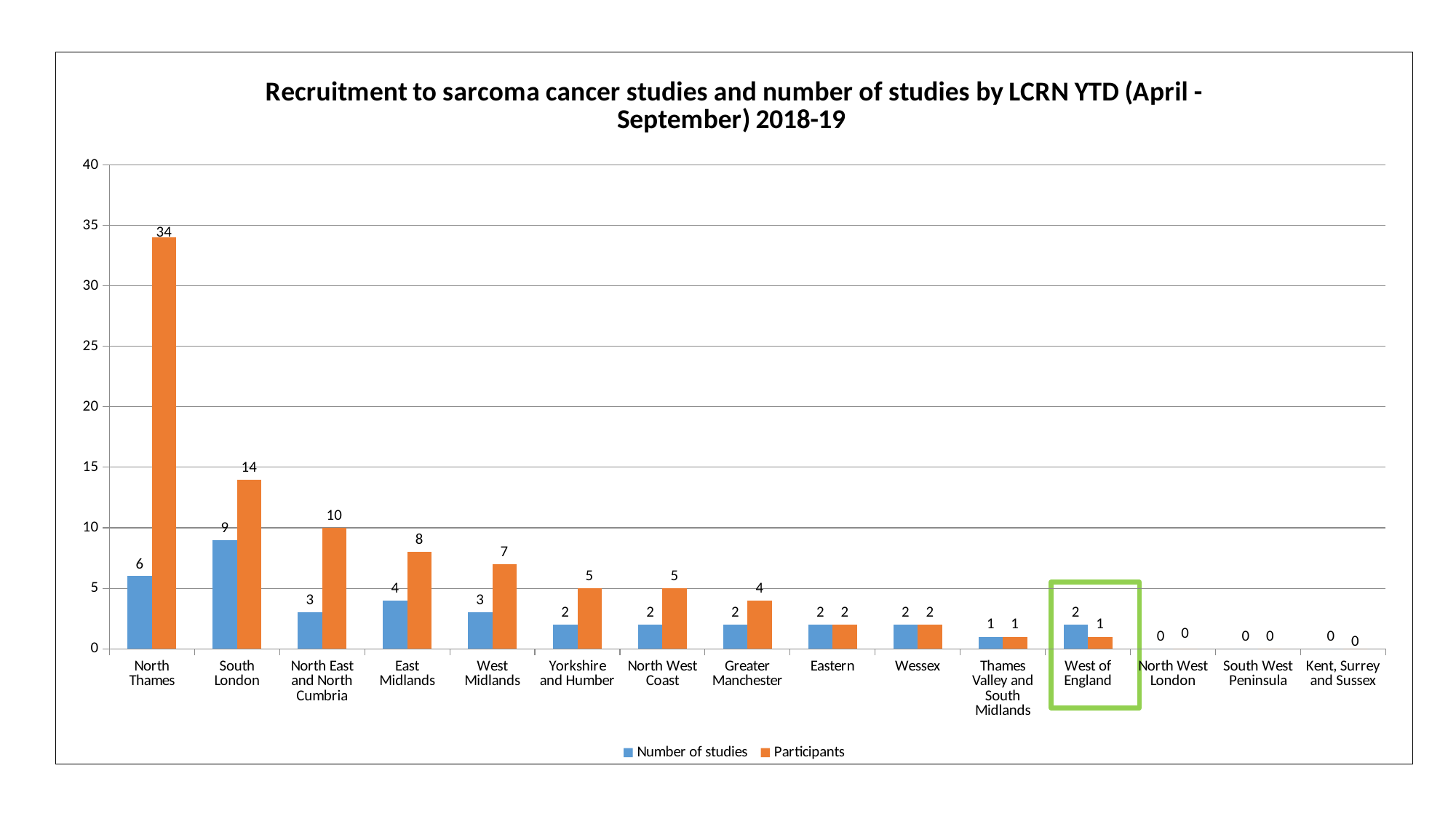
How many Participants are shown for North Thames? 34 How many series does the legend list? 2 What kind of chart is shown on the slide? bar chart How many Participants are shown for West of England? 1 Do the Participants values generally rise or fall from left to right along the x axis? fall Which category is highlighted with a green box? West of England What is the Number of studies for South London? 9 Is the Participants value for North Thames greater or less than 30? greater How many LCRN categories are shown on the x axis? 15 What is the difference between Participants for North Thames and South London? 20 Which LCRN has the highest number of Participants? North Thames Which is larger: Participants for East Midlands or Participants for West Midlands? East Midlands